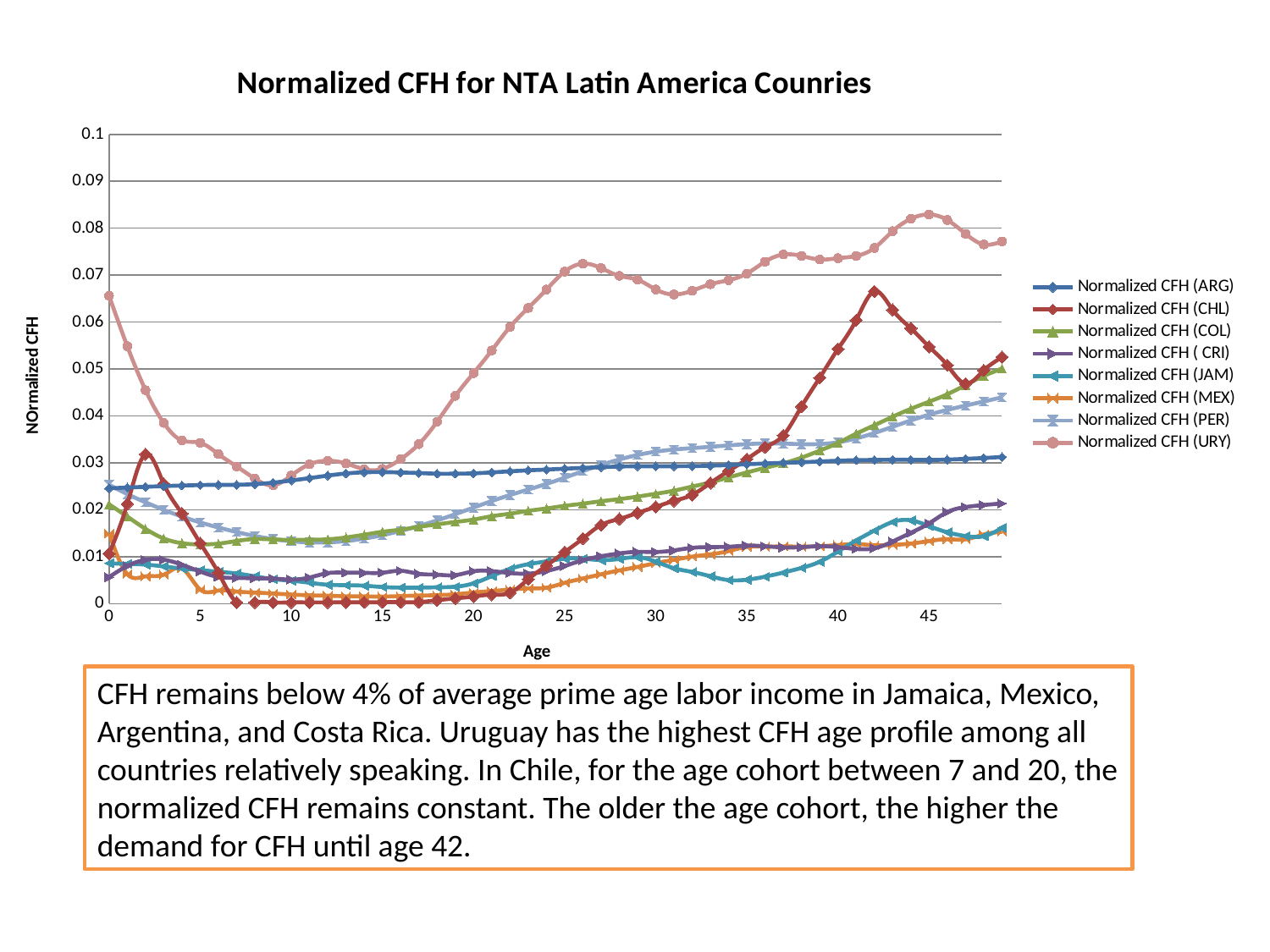
Does the Normalized CFH (URY) series rise or fall between age 0 and age 10? fall Which series has the lowest value at age 15? Normalized CFH (CHL) What kind of chart is shown on the slide? line chart What is the title of the chart? Normalized CFH for NTA Latin America Counries Is the value for Normalized CFH (CHL) at age 42 greater or less than 0.06? greater What is the label of the x axis? Age Which series has the highest value at age 45? Normalized CFH (URY) Is the value for Normalized CFH (MEX) at age 10 greater or less than 0.01? less Is the value for Normalized CFH (URY) at age 45 greater or less than 0.08? greater At age 35, which is larger: Normalized CFH (PER) or Normalized CFH (ARG)? Normalized CFH (PER) How many series does the legend list? 8 Does the Normalized CFH (COL) series rise or fall between age 10 and age 49? rise